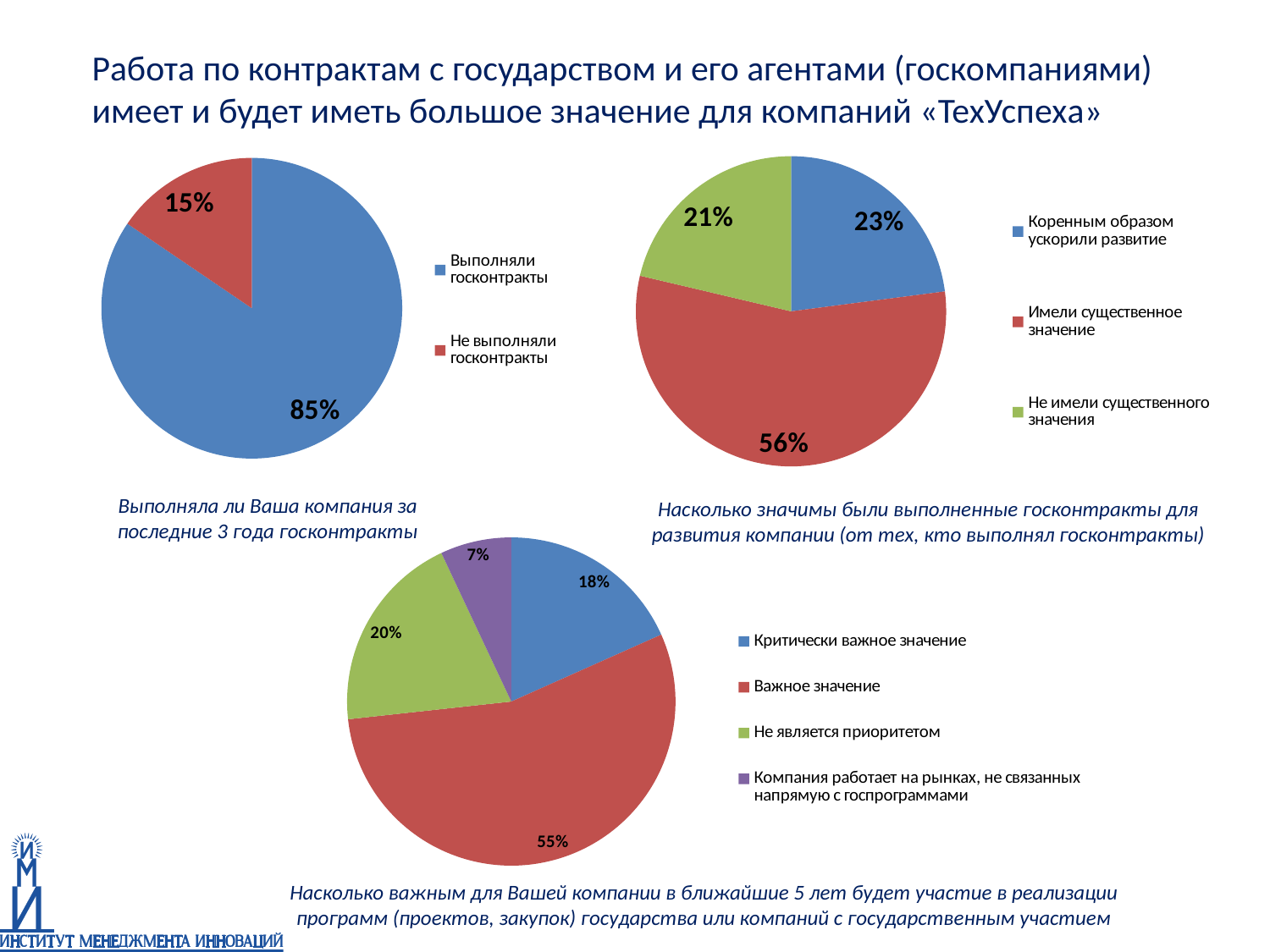
In the bottom pie chart, what is the difference between the "Важное значение" and "Критически важное значение" shares? 37% In the top-left pie chart ("Выполняла ли Ваша компания за последние 3 года госконтракты"), what share is labelled "Выполняли госконтракты"? 85% What type of chart is used for all three charts on the slide? Pie chart In the bottom pie chart ("Насколько важным для Вашей компании в ближайшие 5 лет..."), what share is labelled "Важное значение"? 55% In the top-left pie chart, what is the difference between the "Выполняли госконтракты" and "Не выполняли госконтракты" shares? 70% In the top-right pie chart, how many categories does the legend list? 3 In the top-right pie chart, what share is labelled "Коренным образом ускорили развитие"? 23% In the top-right pie chart, which category has the smallest share? Не имели существенного значения In the bottom pie chart, what share is labelled "Компания работает на рынках, не связанных напрямую с госпрограммами"? 7% In the bottom pie chart, which is larger: "Критически важное значение" or "Не является приоритетом"? Не является приоритетом In the top-left pie chart, what share is labelled "Не выполняли госконтракты"? 15% In the top-right pie chart ("Насколько значимы были выполненные госконтракты для развития компании"), what share is labelled "Имели существенное значение"? 56%